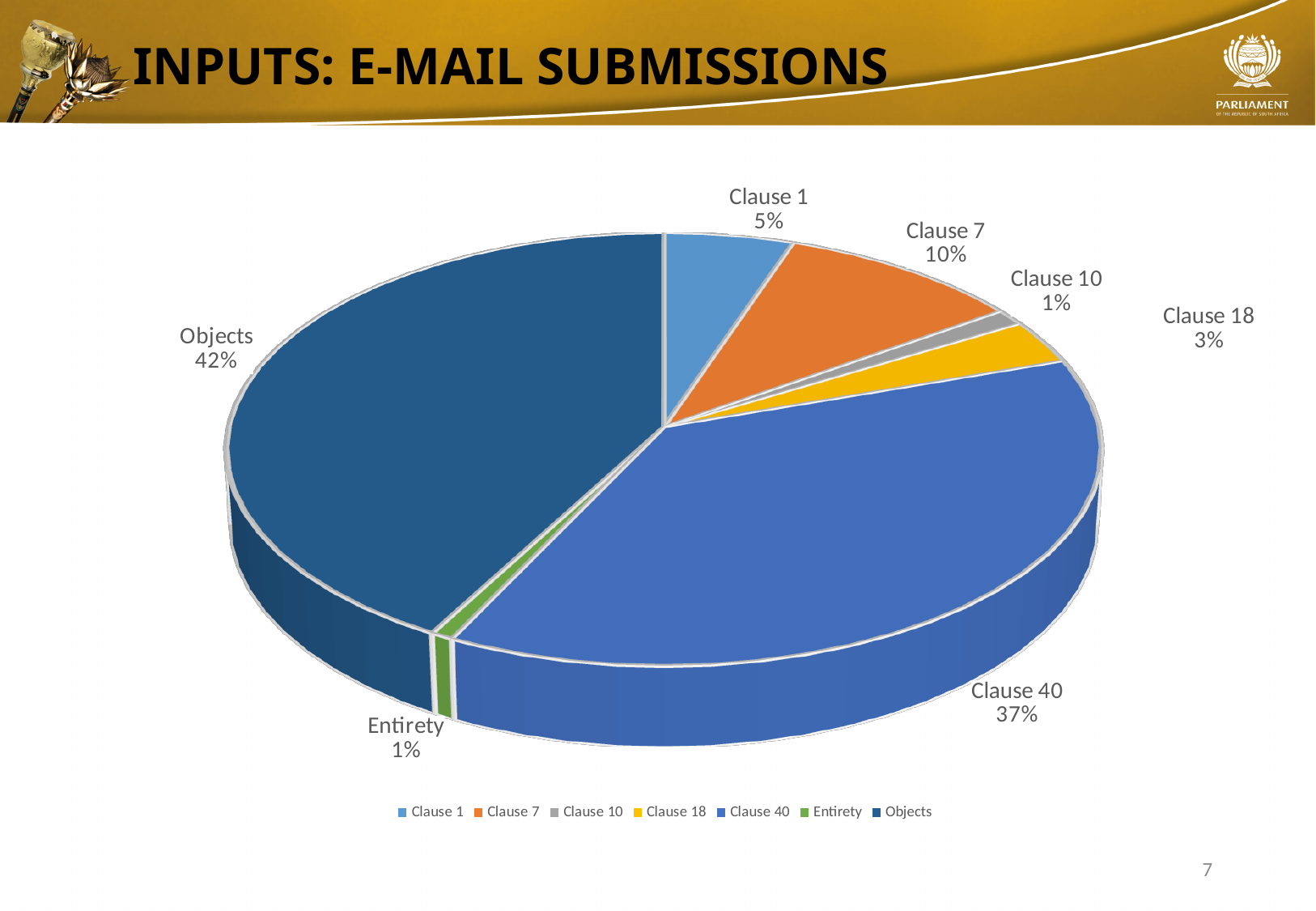
What percentage is shown for Clause 40? 37% What percentage is shown for Clause 7? 10% What is the difference in percentage points between Objects and Clause 40? 5 Which two categories each have a share of 1%? Clause 10 and Entirety What is the difference in percentage points between Clause 7 and Clause 1? 5 What share of e-mail submissions is labelled Objects? 42% What percentage is shown for Clause 18? 3% How many categories does the legend list? 7 What is the title of the slide containing the chart? INPUTS: E-MAIL SUBMISSIONS Which category has the larger share, Clause 1 or Clause 7? Clause 7 Which category has the largest slice of the pie? Objects What kind of chart is shown on the slide? Pie chart